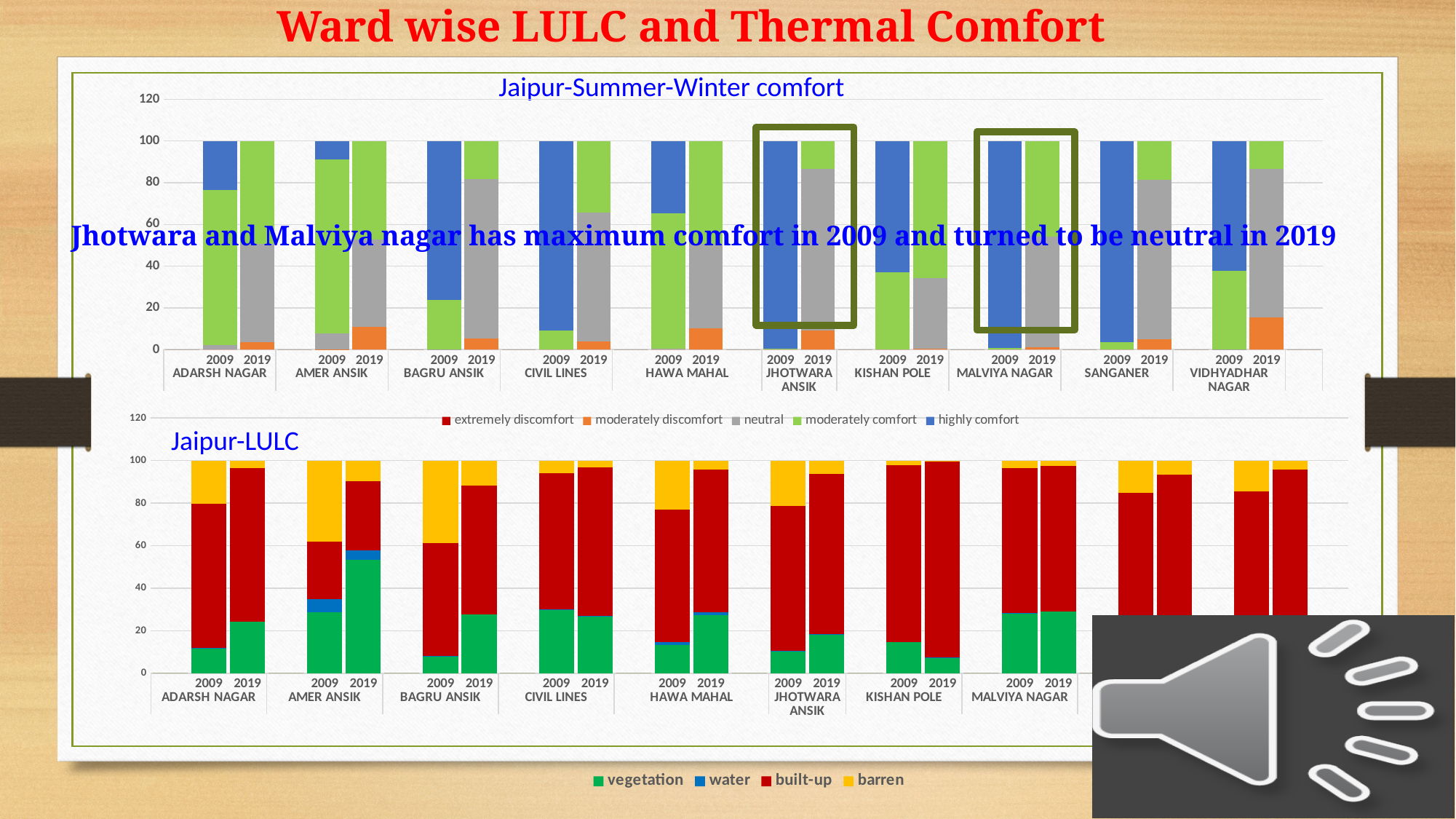
In the Jaipur-Summer-Winter comfort chart, is the highly comfort value for Sanganer in 2009 greater or less than 80? greater How many wards are shown on the x axis of the Jaipur-Summer-Winter comfort chart? 10 In the Jaipur-Summer-Winter comfort chart, which colour represents the neutral series? Grey How many series does the legend of the Jaipur-Summer-Winter comfort chart list? 5 In the Jaipur-Summer-Winter comfort chart, does the highly comfort value for Jhotwara Ansik rise or fall from 2009 to 2019? fall In the Jaipur-Summer-Winter comfort chart, which has the larger highly comfort value in 2009: Jhotwara Ansik or Kishan Pole? Jhotwara Ansik In the Jaipur-LULC chart, which has the larger vegetation value in 2019: Amer Ansik or Adarsh Nagar? Amer Ansik What kind of chart is the Jaipur-Summer-Winter comfort chart at the top of the slide? Stacked bar chart How many series does the legend of the Jaipur-LULC chart list? 4 In the Jaipur-LULC chart, is the vegetation value for Adarsh Nagar in 2009 greater or less than 20? less In the Jaipur-LULC chart, is the vegetation value for Amer Ansik in 2019 greater or less than 40? greater